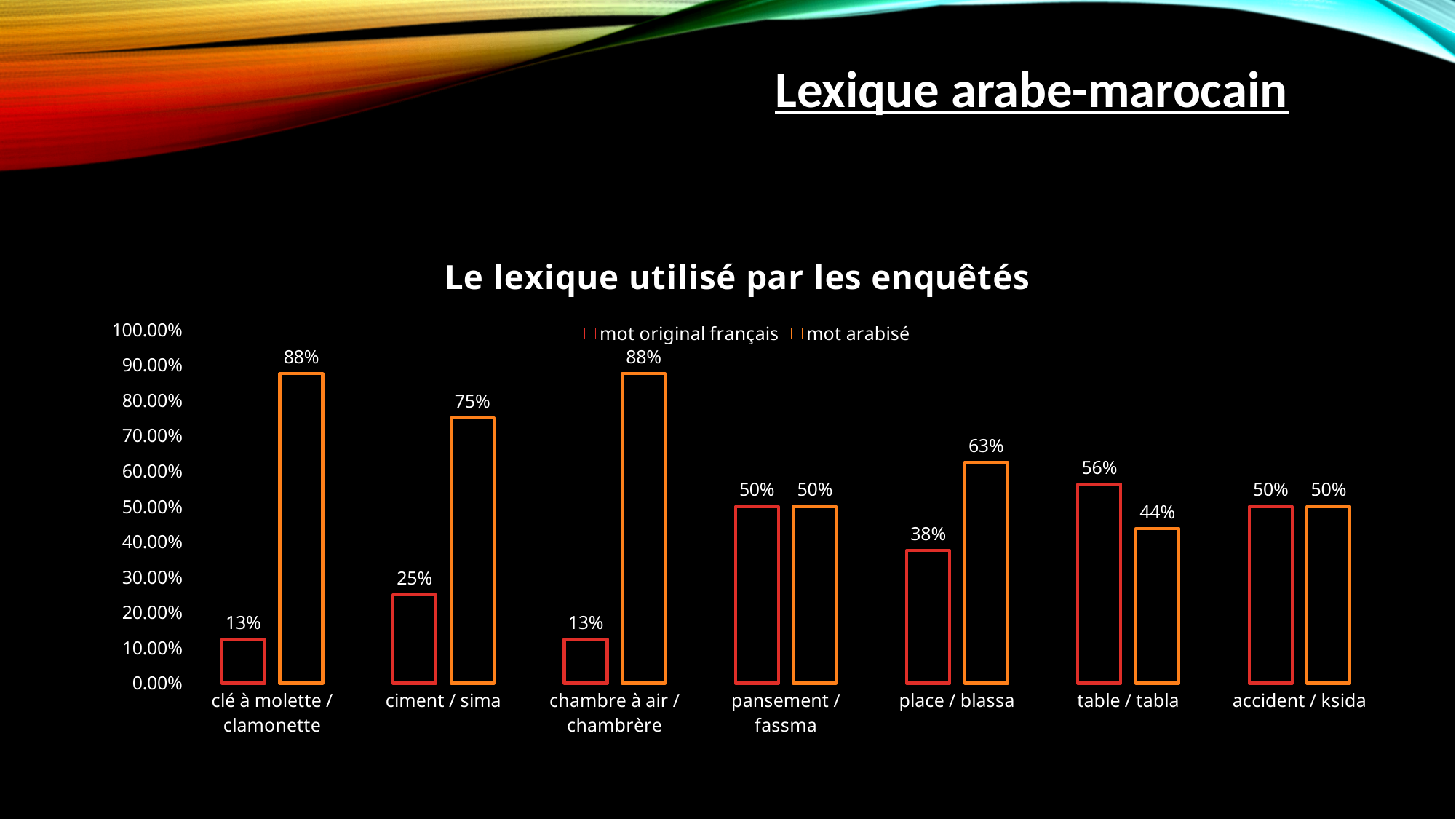
What is the difference between 'mot arabisé' and 'mot original français' for 'clé à molette / clamonette'? 75% Which category has the highest value for 'mot original français'? table / tabla What is the difference between 'mot arabisé' and 'mot original français' for 'place / blassa'? 25% What is the value of 'mot arabisé' for 'ciment / sima'? 75% How many categories are shown on the x axis? 7 For 'table / tabla', which is larger: 'mot original français' or 'mot arabisé'? mot original français Which category has the lowest value for 'mot arabisé'? table / tabla What is the value of 'mot original français' for 'place / blassa'? 38% How many series does the legend list? 2 What is the value of 'mot original français' for 'table / tabla'? 56% What is the title of the chart? Le lexique utilisé par les enquêtés What kind of chart is shown on the slide? bar chart